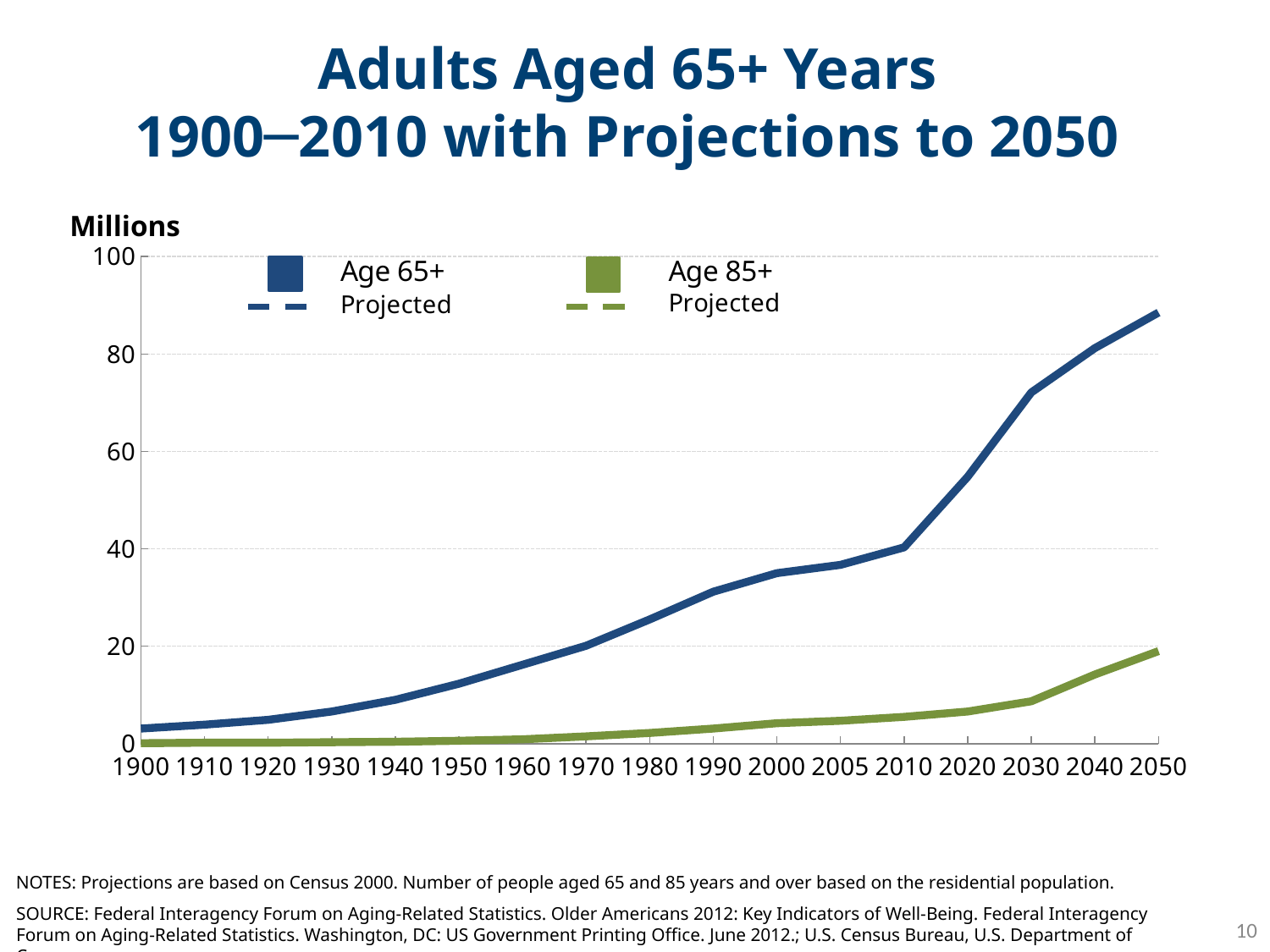
Does the Age 65+ line rise or fall from 1900 to 2050? rise How many series does the legend list? 2 What unit is shown on the y axis label? Millions Is the value for Age 65+ in 2050 greater or less than 80? greater Is the value for Age 65+ in 2030 greater or less than 60? greater Is the value for Age 65+ in 2010 greater or less than 60? less What kind of chart is shown on the slide? line chart In which year does the Age 65+ line reach its highest value? 2050 In 2050, which series has the larger value, Age 65+ or Age 85+? Age 65+ How many years are labelled along the x axis? 17